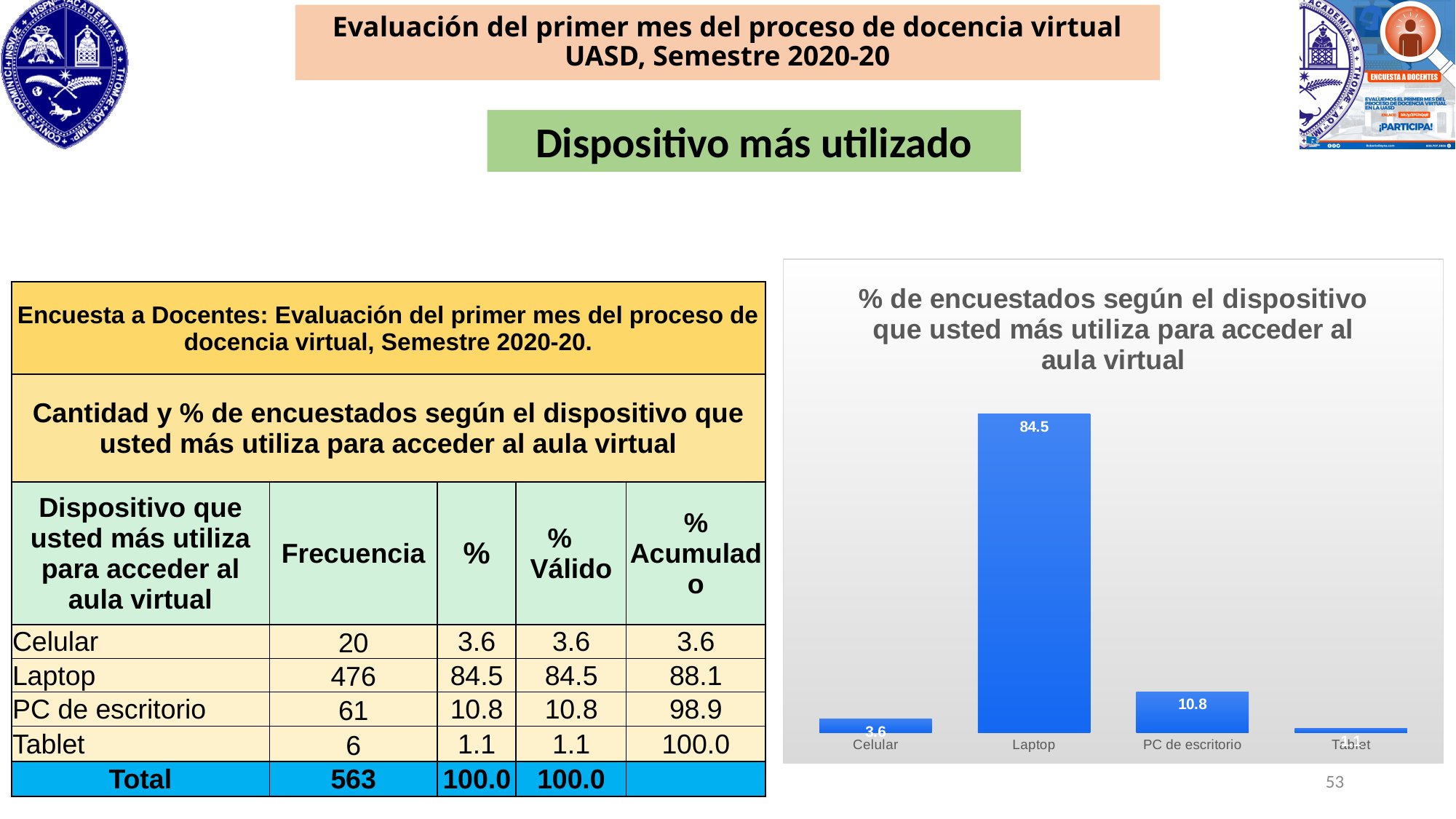
What kind of chart is shown on the slide? Bar chart Which is larger, the value for Celular or the value for PC de escritorio? PC de escritorio Which device has the highest value in the chart? Laptop What is the value for Laptop in the chart? 84.5 Which device has the lowest value in the chart? Tablet What is the difference between the values for Laptop and PC de escritorio? 73.7 What is the value for Celular in the chart? 3.6 What is the value for PC de escritorio in the chart? 10.8 What is the title of the chart? % de encuestados según el dispositivo que usted más utiliza para acceder al aula virtual What colour are the bars in the chart? Blue How many device categories are shown in the chart? 4 What is the difference between the values for PC de escritorio and Celular? 7.2